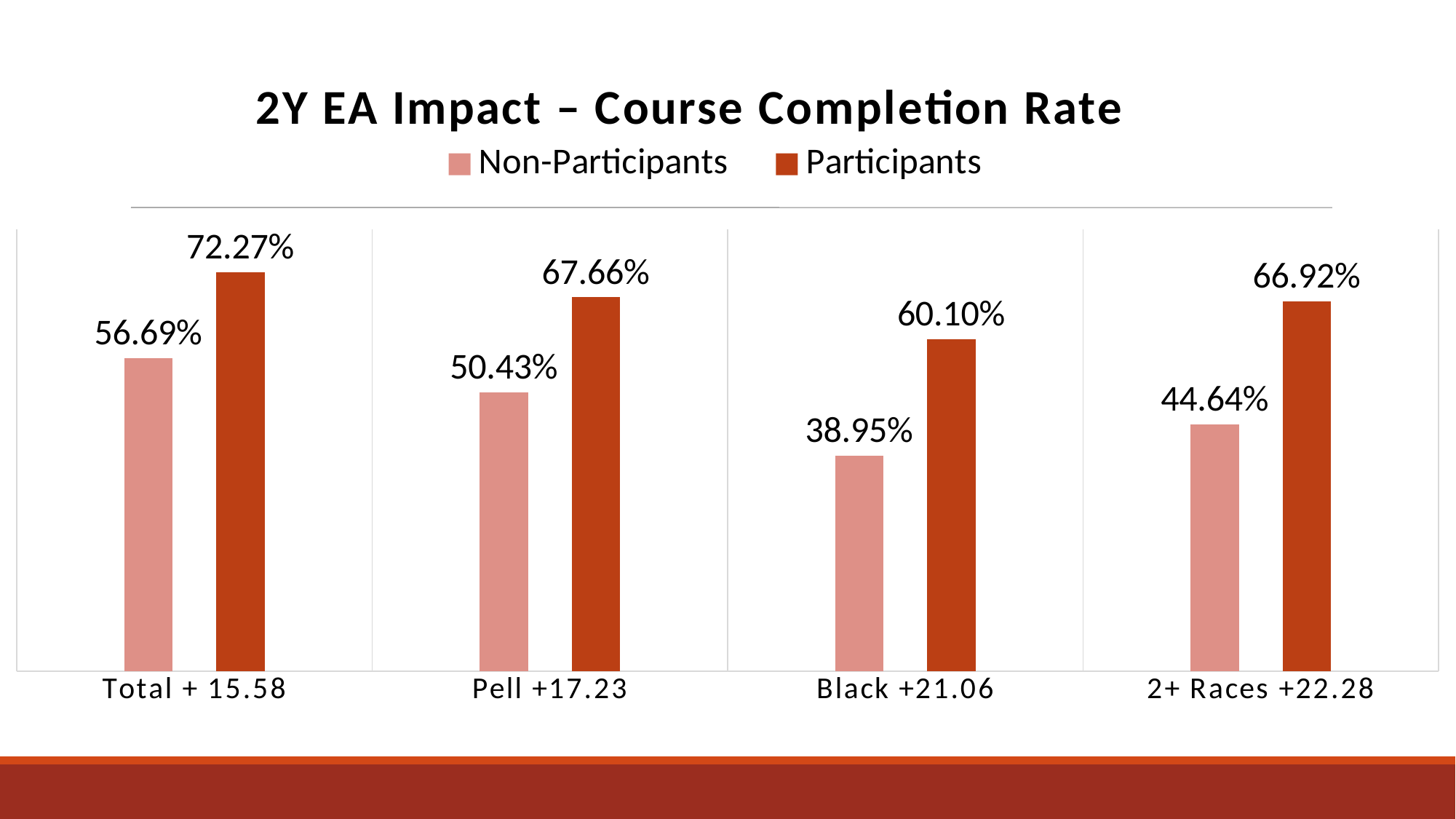
What is the difference between the Participants and Non-Participants course completion rates in the Black +21.06 category? 21.15% What is the course completion rate for Participants in the 2+ Races +22.28 category? 66.92% What is the course completion rate for Non-Participants in the Pell +17.23 category? 50.43% What is the title of the chart? 2Y EA Impact – Course Completion Rate How many series does the legend list? 2 Which category has the highest Participants course completion rate? Total + 15.58 Which category has the lowest Non-Participants course completion rate? Black +21.06 What kind of chart is shown on the slide? Bar chart What is the course completion rate for Non-Participants in the Black +21.06 category? 38.95% Which is larger in the Pell +17.23 category: the Participants rate or the Non-Participants rate? Participants What is the course completion rate for Participants in the Total + 15.58 category? 72.27% How many categories are shown on the x axis? 4